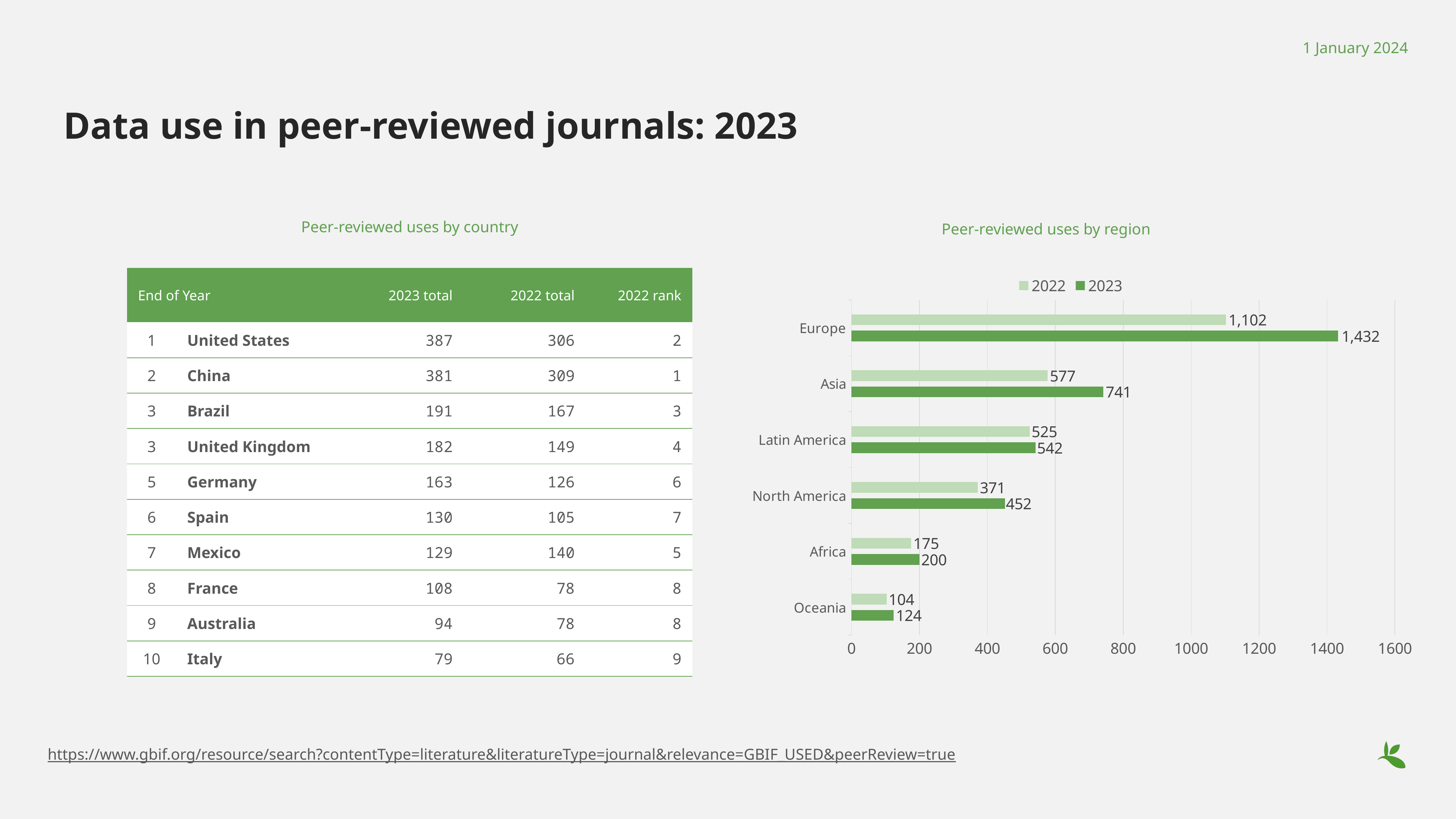
In the 'Peer-reviewed uses by region' chart, what is the 2023 value for Europe? 1,432 What kind of chart is 'Peer-reviewed uses by region'? bar chart In the 'Peer-reviewed uses by region' chart, what is the difference between the 2023 and 2022 values for Europe? 330 In the 'Peer-reviewed uses by region' chart, what is the difference between the 2023 and 2022 values for Asia? 164 In the 'Peer-reviewed uses by region' chart, which is larger: the 2023 value for Latin America or the 2023 value for North America? Latin America How many series does the legend of the 'Peer-reviewed uses by region' chart list? 2 In the 'Peer-reviewed uses by region' chart, which region has the highest 2023 value? Europe In the 'Peer-reviewed uses by region' chart, is the 2023 value for Africa greater or less than 400? less In the 'Peer-reviewed uses by region' chart, what is the 2023 value for North America? 452 In the 'Peer-reviewed uses by region' chart, what is the 2022 value for Asia? 577 In the 'Peer-reviewed uses by region' chart, which region has the lowest 2022 value? Oceania How many regions are shown in the 'Peer-reviewed uses by region' chart? 6